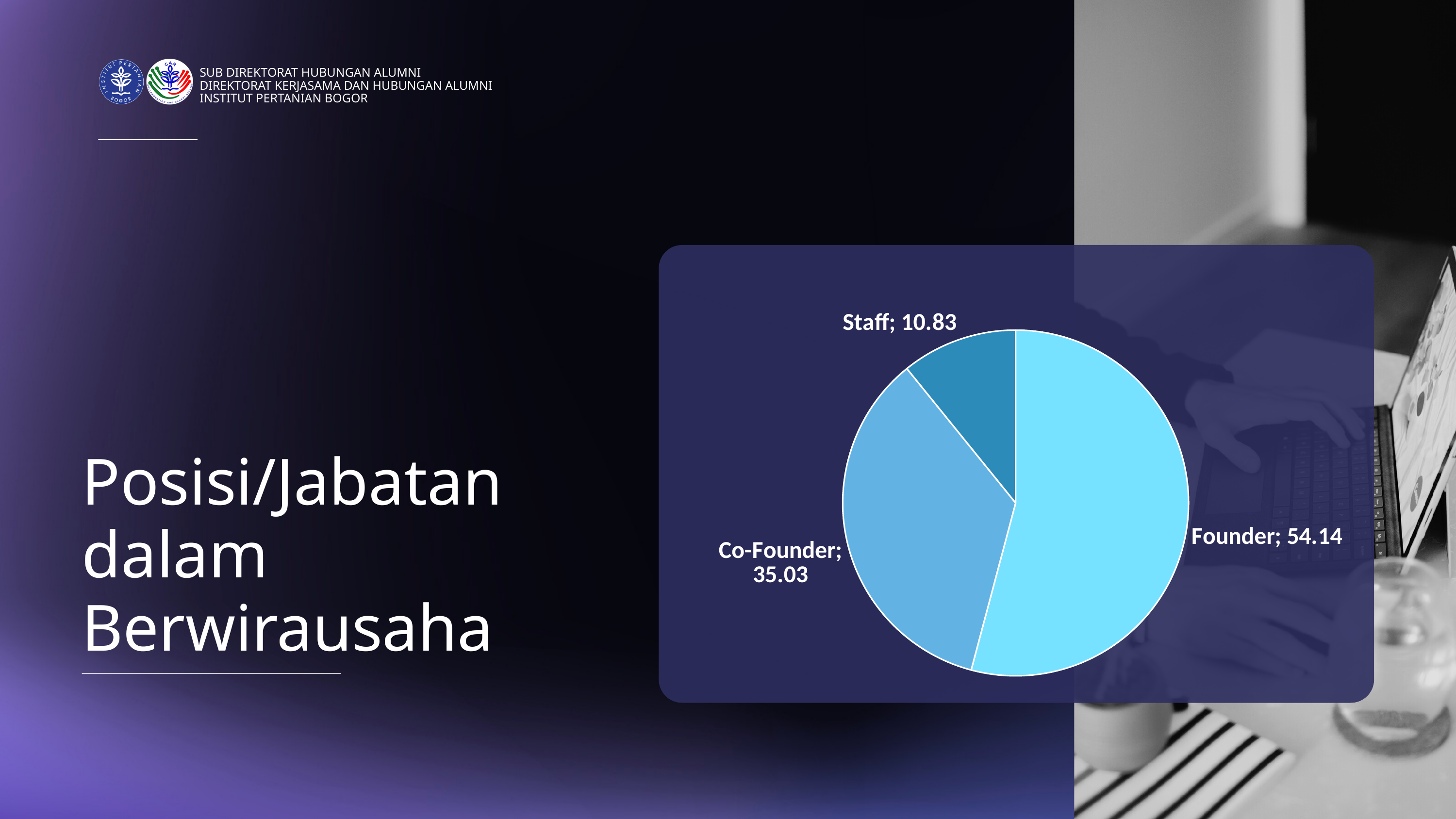
Which is larger, the value for Co-Founder or the value for Staff? Co-Founder What is the difference between the Founder and Co-Founder values? 19.11 Which slice is shown in the darkest blue colour? Staff What is the value for Co-Founder? 35.03 What is the value for Founder? 54.14 Which category has the smallest slice? Staff What is the difference between the Co-Founder and Staff values? 24.20 What is the value for Staff? 10.83 How many slices does the pie chart have? 3 What kind of chart is shown on the slide? pie chart Which category has the largest slice? Founder What is the title text shown to the left of the chart? Posisi/Jabatan dalam Berwirausaha